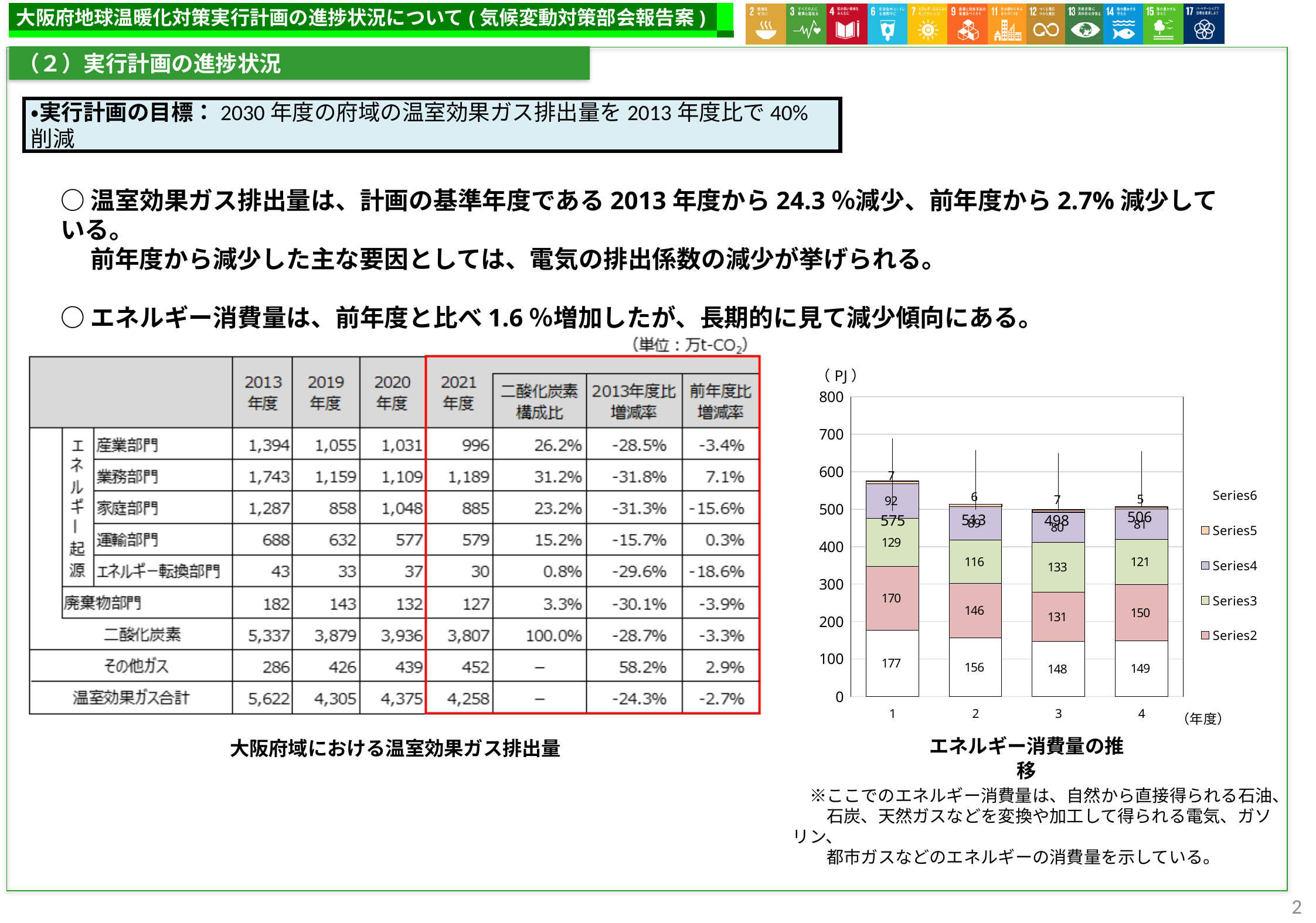
In the エネルギー消費量の推移 chart, which category has the highest Series2 value? 1 In the エネルギー消費量の推移 chart, what is the Series2 value for category 1? 170 What kind of chart is the エネルギー消費量の推移 chart? stacked bar chart How many categories are shown on the x axis of the エネルギー消費量の推移 chart? 4 In the エネルギー消費量の推移 chart, what is the value of the bottom segment of the bar for category 2? 156 In the エネルギー消費量の推移 chart, which category has the lowest Series3 value? 2 What unit is shown above the y axis of the エネルギー消費量の推移 chart? PJ How many series does the legend of the エネルギー消費量の推移 chart list? 5 In the エネルギー消費量の推移 chart, what is the difference between the Series2 values for category 1 and category 4? 20 In the エネルギー消費量の推移 chart, what is the Series3 value for category 3? 133 In the エネルギー消費量の推移 chart, which is larger: the Series3 value for category 1 or for category 4? category 1 In the エネルギー消費量の推移 chart, is the total height of the bar for category 1 greater or less than 500? greater